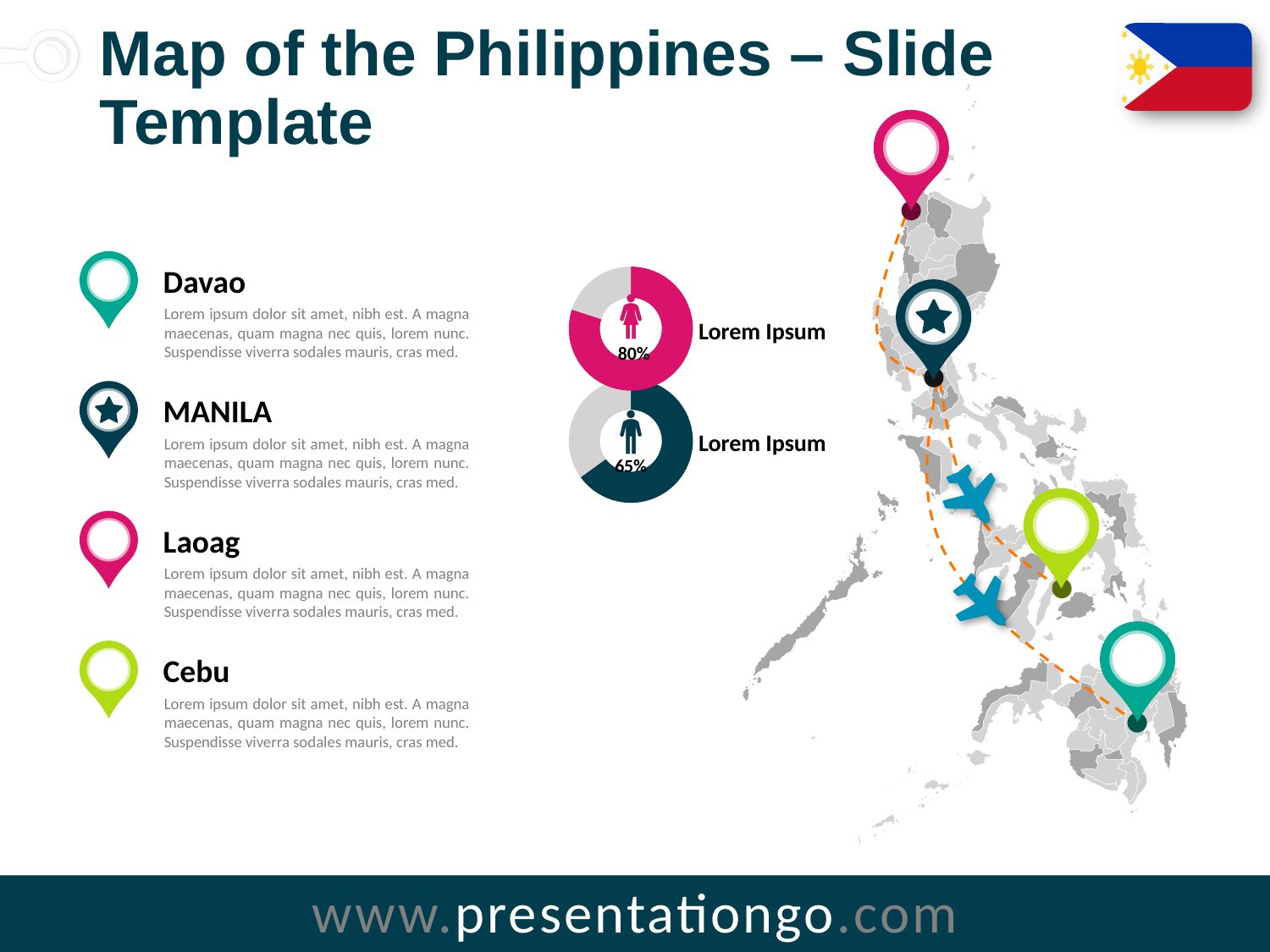
What label text appears to the right of each donut chart? Lorem Ipsum What value is shown on the top donut chart (the pink one with the female icon)? 80% What is the difference in percentage points between the top donut chart's value and the bottom donut chart's value? 15 percentage points What colour is the filled portion of the top donut chart? pink Which donut chart shows the smaller percentage, the one with the female icon or the one with the male icon? the one with the male icon What share of the bottom donut chart is filled in dark teal? 65% What kind of charts are shown in the middle of the slide? donut charts What share of the top donut chart is filled in pink? 80% What value is shown on the bottom donut chart (the dark teal one with the male icon)? 65% How many donut charts are on the slide? 2 Which of the two donut charts shows the larger percentage, the top (pink) one or the bottom (dark teal) one? the top (pink) one